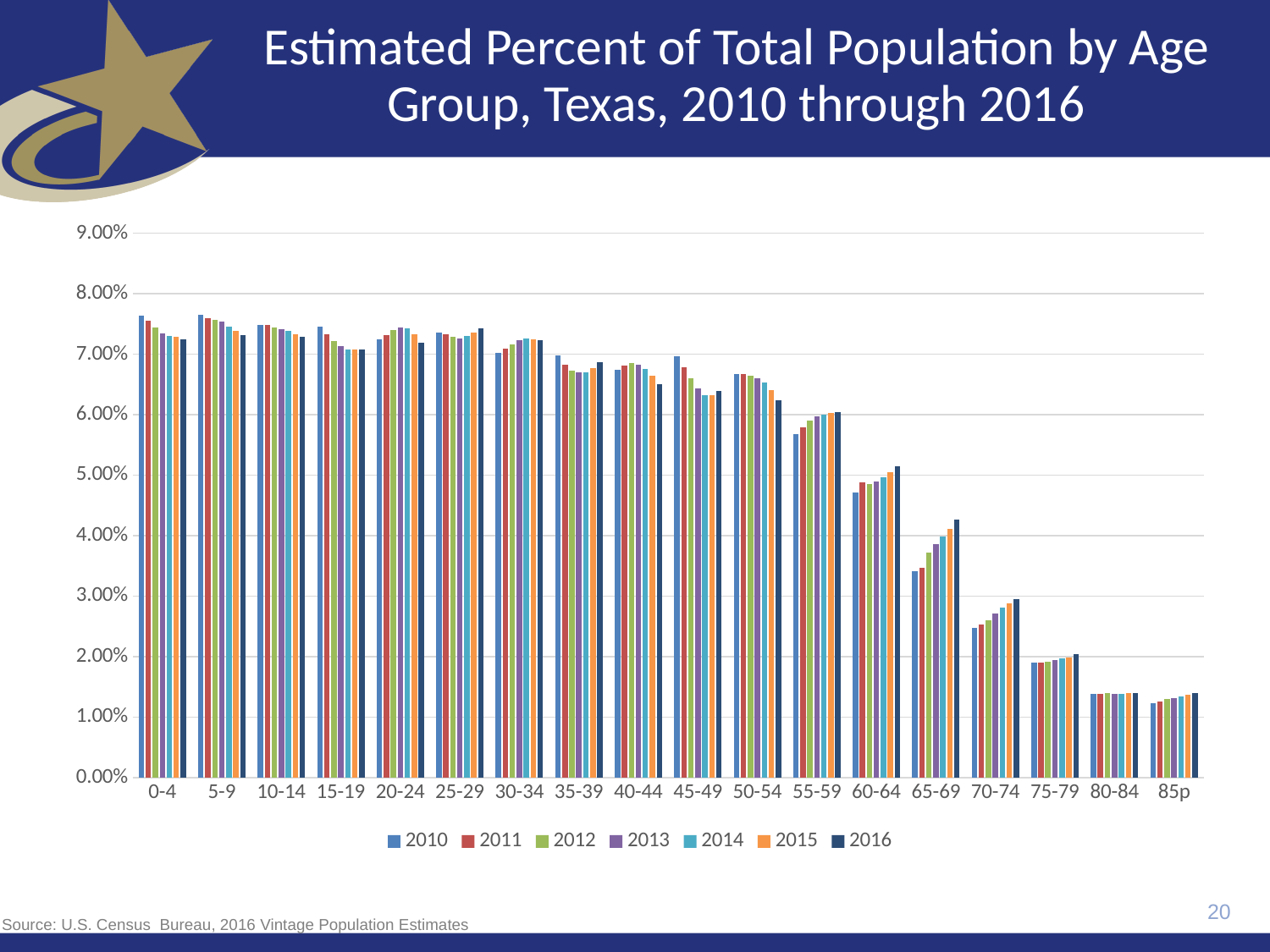
Do the values generally rise or fall as the age groups move from left to right along the x axis? fall How many age group categories are shown on the x axis? 18 What is the title of the chart? Estimated Percent of Total Population by Age Group, Texas, 2010 through 2016 Is the 2010 value for the 55-59 age group greater or less than 6.00%? less How many series does the legend list? 7 Is the 2010 value for the 65-69 age group greater or less than 4.00%? less Is the 2010 value for the 70-74 age group greater or less than 3.00%? less Which age group has the lowest values across all years? 85p For the 65-69 age group, which year has the larger value, 2010 or 2016? 2016 What kind of chart is shown on the slide? bar chart For the 0-4 age group, which year has the larger value, 2010 or 2016? 2010